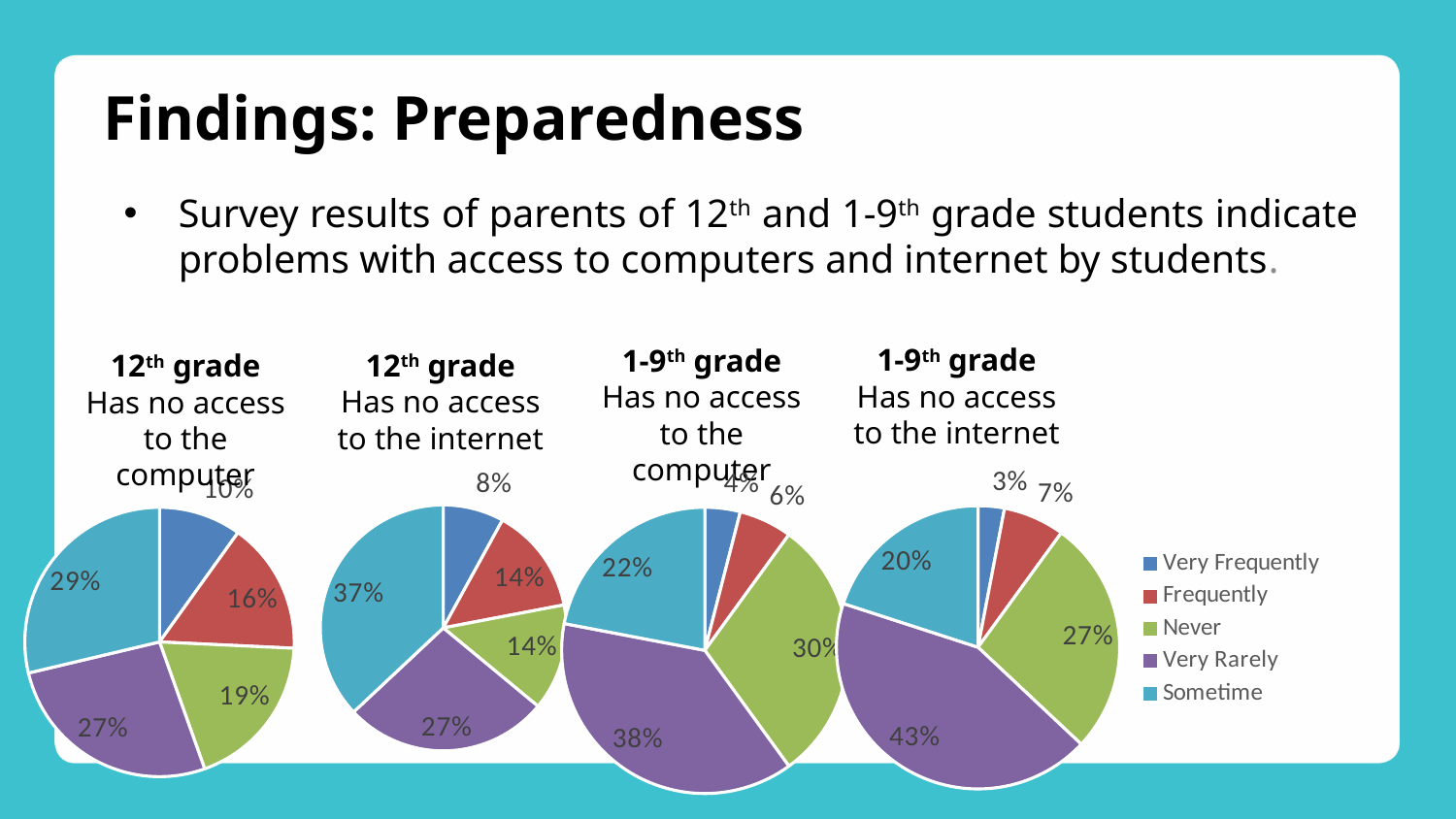
In the "12th grade Has no access to the internet" pie chart, which is larger, the Sometime slice or the Very Rarely slice? Sometime In the "1-9th grade Has no access to the computer" pie chart, what is the difference between the Very Rarely share and the Sometime share? 16% In the "12th grade Has no access to the computer" pie chart, what share is labelled for the Sometime slice? 29% In the "1-9th grade Has no access to the internet" pie chart, which category has the smallest slice? Very Frequently How many pie charts are shown on the slide? 4 In the "12th grade Has no access to the internet" pie chart, what share is labelled for the Very Rarely slice? 27% In the "1-9th grade Has no access to the internet" pie chart, what share is labelled for the Frequently slice? 7% In the "1-9th grade Has no access to the internet" pie chart, which category has the largest slice? Very Rarely In the "12th grade Has no access to the computer" pie chart, which category has the smallest slice? Very Frequently How many series does the legend list for the pie charts? 5 What kind of chart is used for the "1-9th grade Has no access to the internet" data? Pie chart